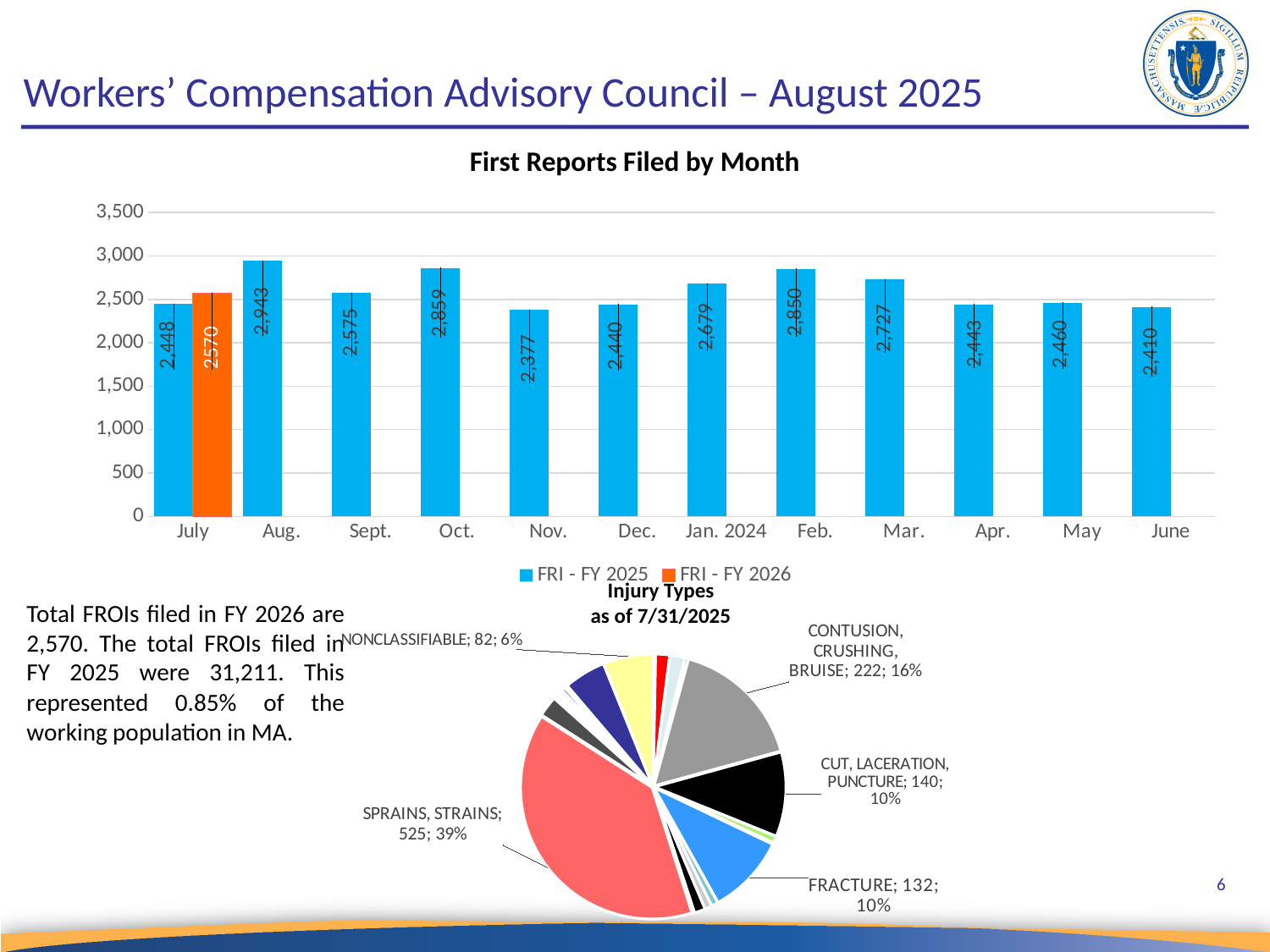
In the 'First Reports Filed by Month' chart, what is the difference between the Aug. value and the Nov. value? 566 What kind of chart is 'First Reports Filed by Month'? bar chart In the 'First Reports Filed by Month' chart, is the value for Nov. greater or less than 2,500? less How many months are shown on the x axis of the 'First Reports Filed by Month' chart? 12 In the 'First Reports Filed by Month' chart, which month has the lowest FRI - FY 2025 value? Nov. In the 'First Reports Filed by Month' chart, which month has the highest FRI - FY 2025 value? Aug. In the 'First Reports Filed by Month' chart, what is the FRI - FY 2026 value for July? 2,570 How many series does the legend of the 'First Reports Filed by Month' chart list? 2 In the 'Injury Types as of 7/31/2025' pie chart, how many reports are for SPRAINS, STRAINS? 525 In the 'Injury Types as of 7/31/2025' pie chart, what share of the pie is CONTUSION, CRUSHING, BRUISE? 16% In the 'First Reports Filed by Month' chart, which is larger, the value for Mar. or the value for Apr.? Mar. In the 'First Reports Filed by Month' chart, what is the value for Aug.? 2,943